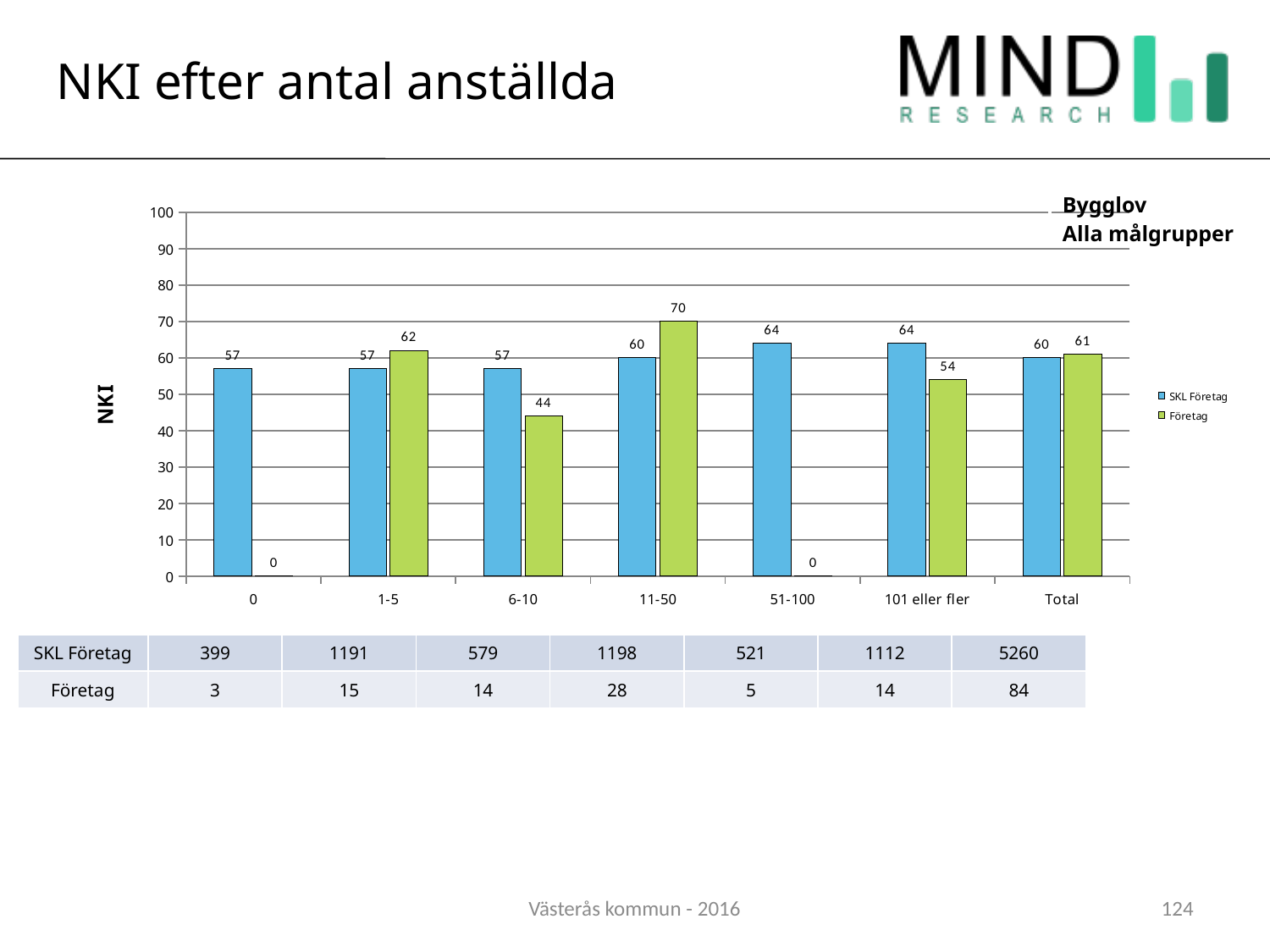
What is the difference between the Företag and SKL Företag values in the 11-50 category? 10 What kind of chart is shown on the slide? Bar chart How many categories are shown on the x axis? 7 What is the NKI value for SKL Företag in the 51-100 category? 64 What is the NKI value for Företag in the 6-10 category? 44 In the 101 eller fler category, which series has the larger value, SKL Företag or Företag? SKL Företag What is the label of the y axis? NKI Which category has the highest NKI value for the Företag series? 11-50 How many series does the legend list? 2 What is the NKI value for SKL Företag in the 11-50 category? 60 What is the NKI value for Företag in the Total category? 61 Which category has the lowest non-zero NKI value for the Företag series? 6-10